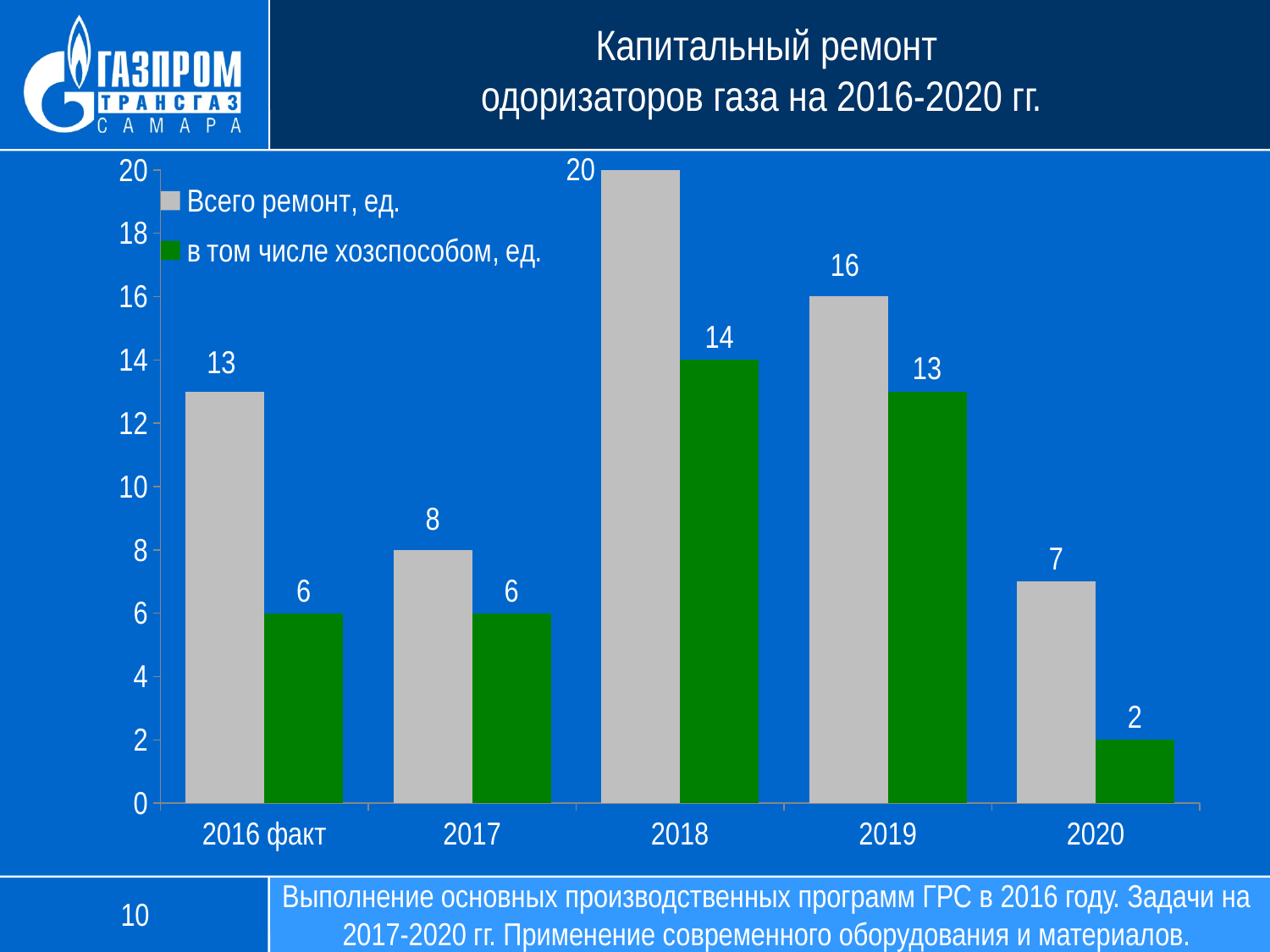
What is the difference between 'Всего ремонт, ед.' and 'в том числе хозспособом, ед.' in 2016 факт? 7 How many years (categories) are shown on the x axis? 5 Which is larger: 'Всего ремонт, ед.' in 2017 or 'Всего ремонт, ед.' in 2020? 2017 How many series does the legend list? 2 What is the value of 'в том числе хозспособом, ед.' for 2020? 2 Which year has the lowest value for 'в том числе хозспособом, ед.'? 2020 What colour are the bars for 'в том числе хозспособом, ед.'? Green What is the value of 'в том числе хозспособом, ед.' for 2019? 13 What kind of chart is shown on the slide? Bar chart Does the value of 'Всего ремонт, ед.' rise or fall from 2018 to 2020? Fall Which year has the highest value for 'Всего ремонт, ед.'? 2018 What is the value of 'Всего ремонт, ед.' for 2018? 20